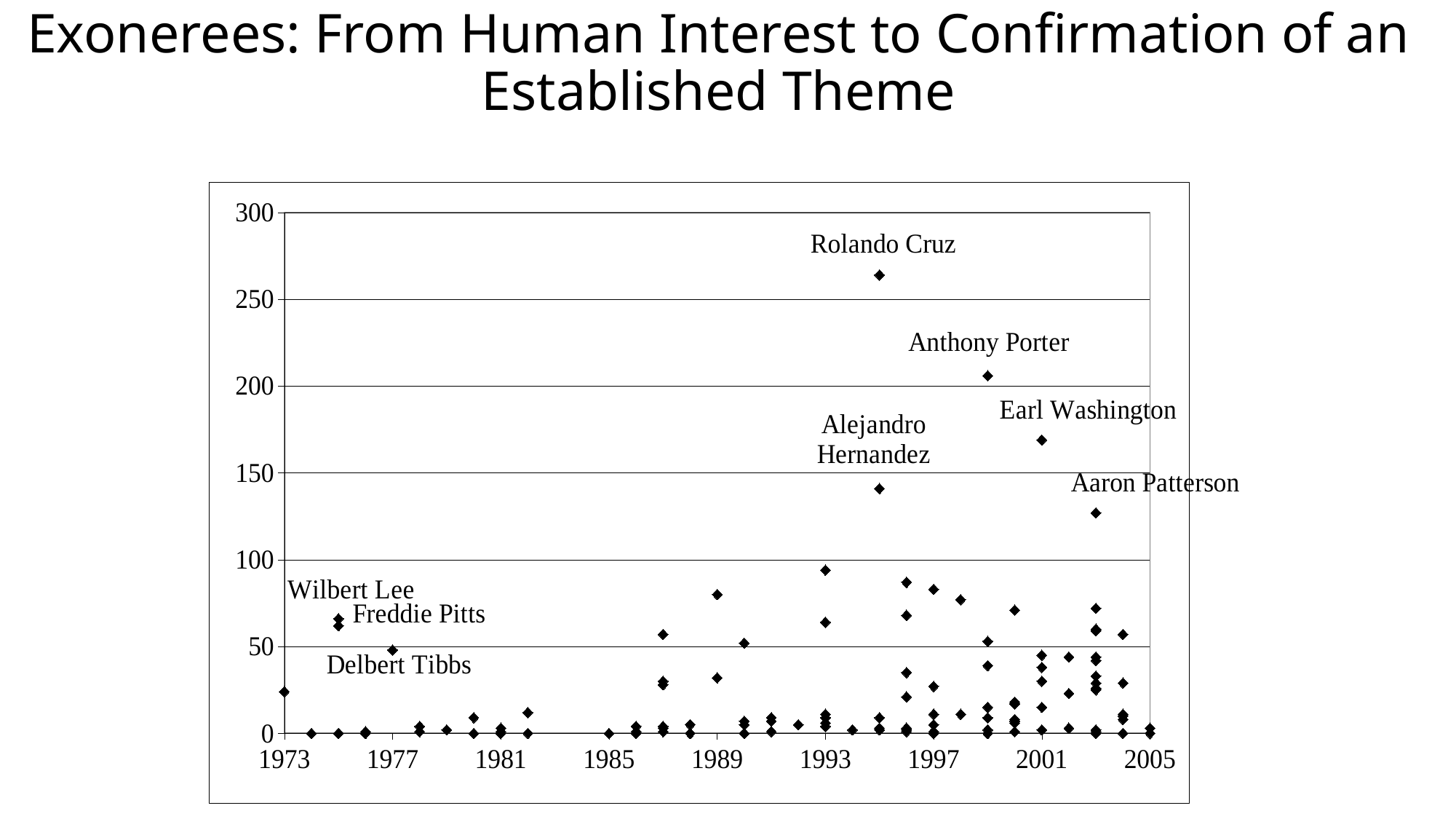
Which has the larger value, Anthony Porter or Earl Washington? Anthony Porter Is the value for Anthony Porter greater or less than 250? less What is the title of the slide? Exonerees: From Human Interest to Confirmation of an Established Theme What is the highest value shown on the y axis? 300 Is the value for Aaron Patterson greater or less than 150? less What kind of chart is shown on the slide? scatter plot Is the value for Rolando Cruz greater or less than 250? greater Which has the larger value, Rolando Cruz or Alejandro Hernandez? Rolando Cruz Which labeled exoneree has the highest point on the chart? Rolando Cruz